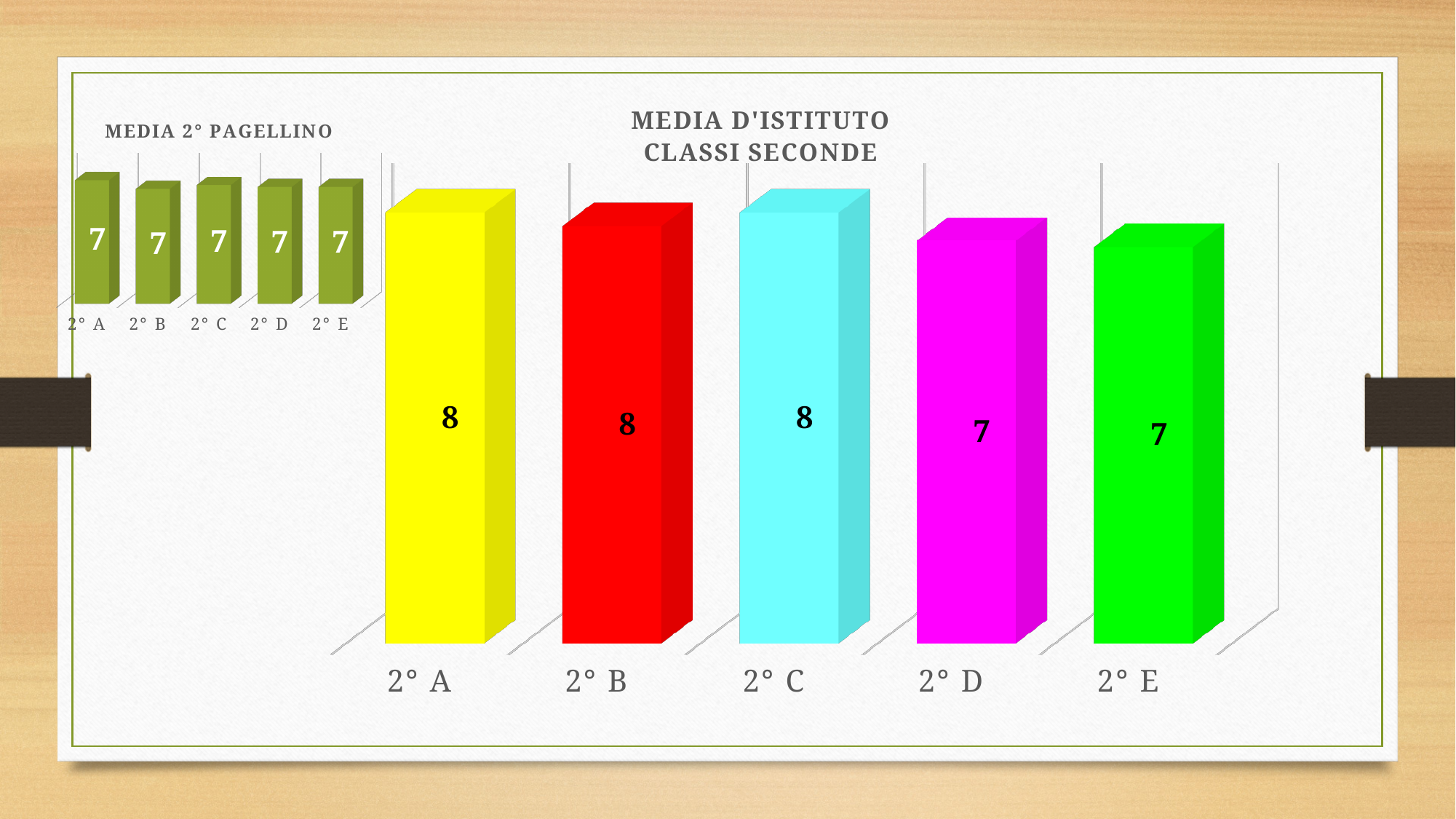
In the 'MEDIA D'ISTITUTO CLASSI SECONDE' chart, what is the value for 2° A? 8 In the 'MEDIA D'ISTITUTO CLASSI SECONDE' chart, what is the difference between the values for 2° C and 2° D? 1 What kind of chart is the 'MEDIA D'ISTITUTO CLASSI SECONDE' chart? Bar chart In the 'MEDIA 2° PAGELLINO' chart, what is the value for 2° C? 7 In the 'MEDIA D'ISTITUTO CLASSI SECONDE' chart, what is the value for 2° D? 7 How many categories are shown in the 'MEDIA 2° PAGELLINO' chart? 5 How many categories are shown in the 'MEDIA D'ISTITUTO CLASSI SECONDE' chart? 5 In the 'MEDIA D'ISTITUTO CLASSI SECONDE' chart, what colour is the bar for 2° C? Cyan What is the title of the larger chart on the slide? MEDIA D'ISTITUTO CLASSI SECONDE In the 'MEDIA 2° PAGELLINO' chart, do the values rise, fall or stay the same from 2° A to 2° E? Stay the same In the 'MEDIA D'ISTITUTO CLASSI SECONDE' chart, what is the value for 2° E? 7 In the 'MEDIA D'ISTITUTO CLASSI SECONDE' chart, which is larger, the value for 2° B or the value for 2° E? 2° B